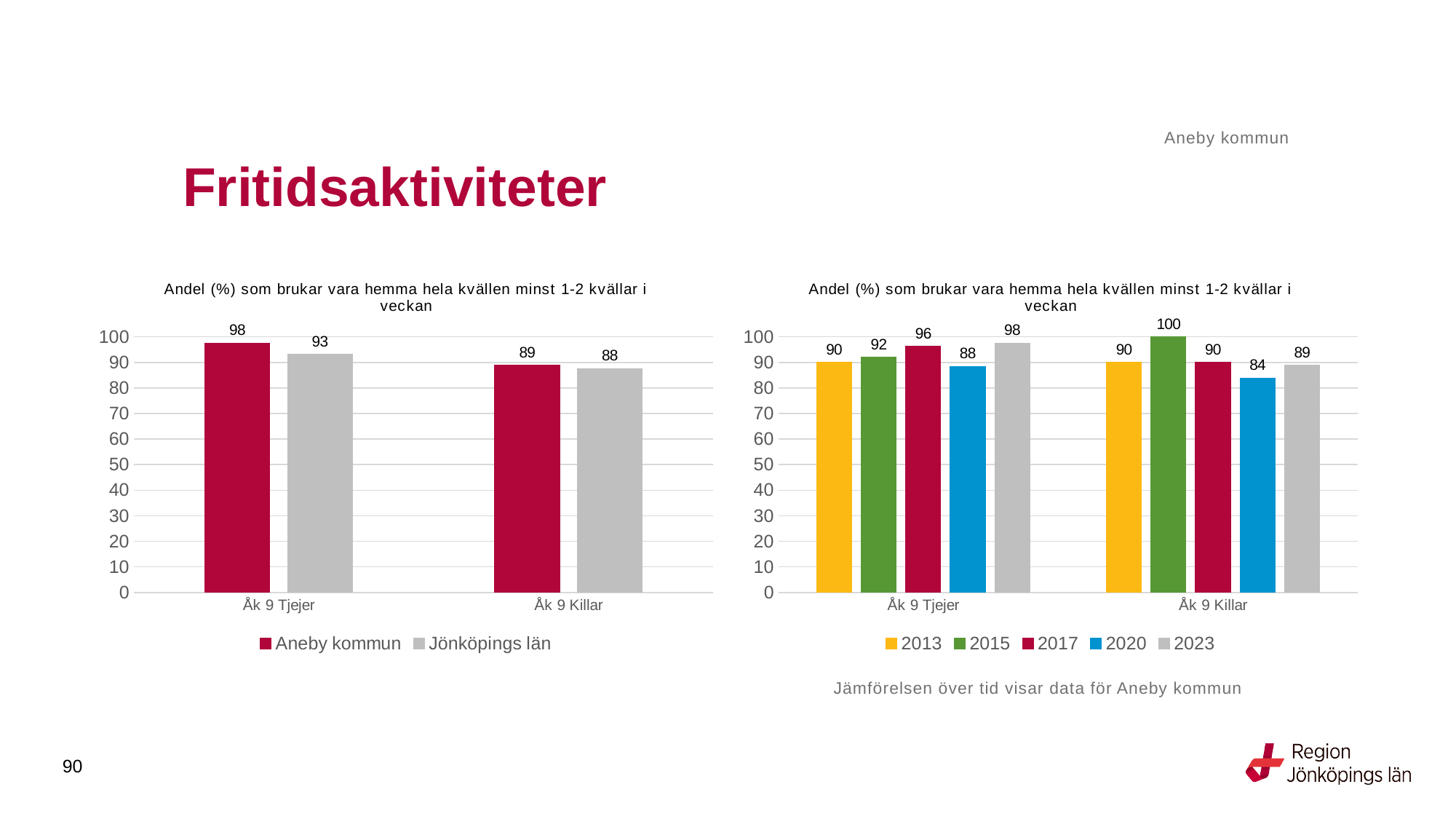
In the left chart, what is the value for Aneby kommun for Åk 9 Tjejer? 98 In the left chart, what is the difference between Aneby kommun and Jönköpings län for Åk 9 Tjejer? 5 In the right chart, which is larger for Åk 9 Killar: the 2017 value or the 2020 value? 2017 In the right chart, how many series does the legend list? 5 In the left chart, what is the value for Jönköpings län for Åk 9 Killar? 88 In the left chart, what kind of chart is shown? Bar chart In the right chart, what is the value for 2015 for Åk 9 Killar? 100 In the right chart, what is the difference between the 2023 values for Åk 9 Tjejer and Åk 9 Killar? 9 In the right chart, which year has the highest value for Åk 9 Tjejer? 2023 In the right chart, what is the value for 2020 for Åk 9 Tjejer? 88 In the left chart, how many series does the legend list? 2 In the right chart, which year has the lowest value for Åk 9 Killar? 2020